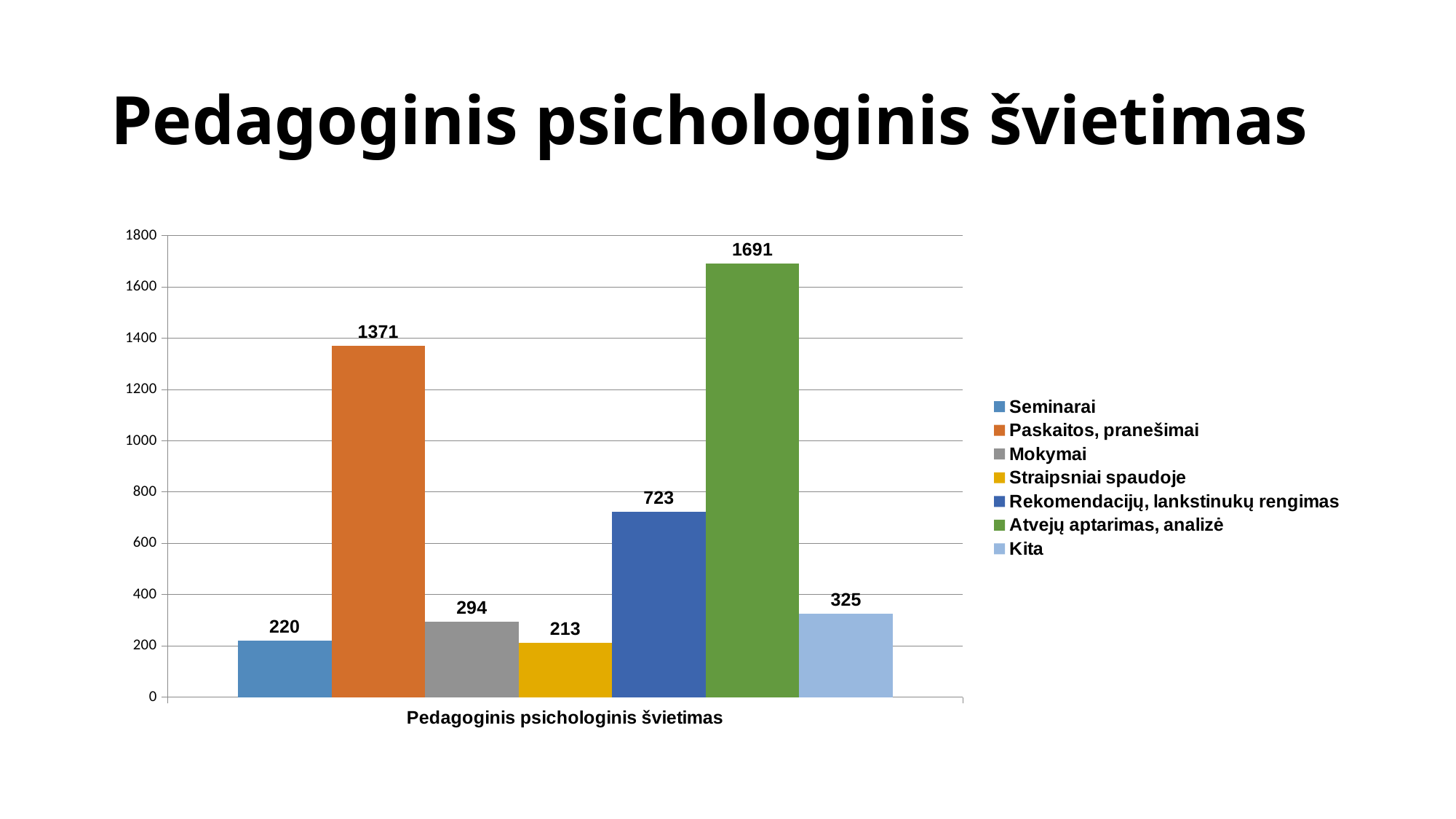
What is the value for Rekomendacijų, lankstinukų rengimas? 723 What is the difference between Atvejų aptarimas, analizė and Paskaitos, pranešimai? 320 What kind of chart is shown on the slide? bar chart What is the value for Paskaitos, pranešimai? 1371 Which is larger, Mokymai or Kita? Kita Which series has the highest value? Atvejų aptarimas, analizė What is the x-axis category label shown below the bars? Pedagoginis psichologinis švietimas Which series has the lowest value? Straipsniai spaudoje How many series does the legend list? 7 Is the value for Rekomendacijų, lankstinukų rengimas greater or less than 800? less What is the value for Seminarai? 220 What is the value for Kita? 325